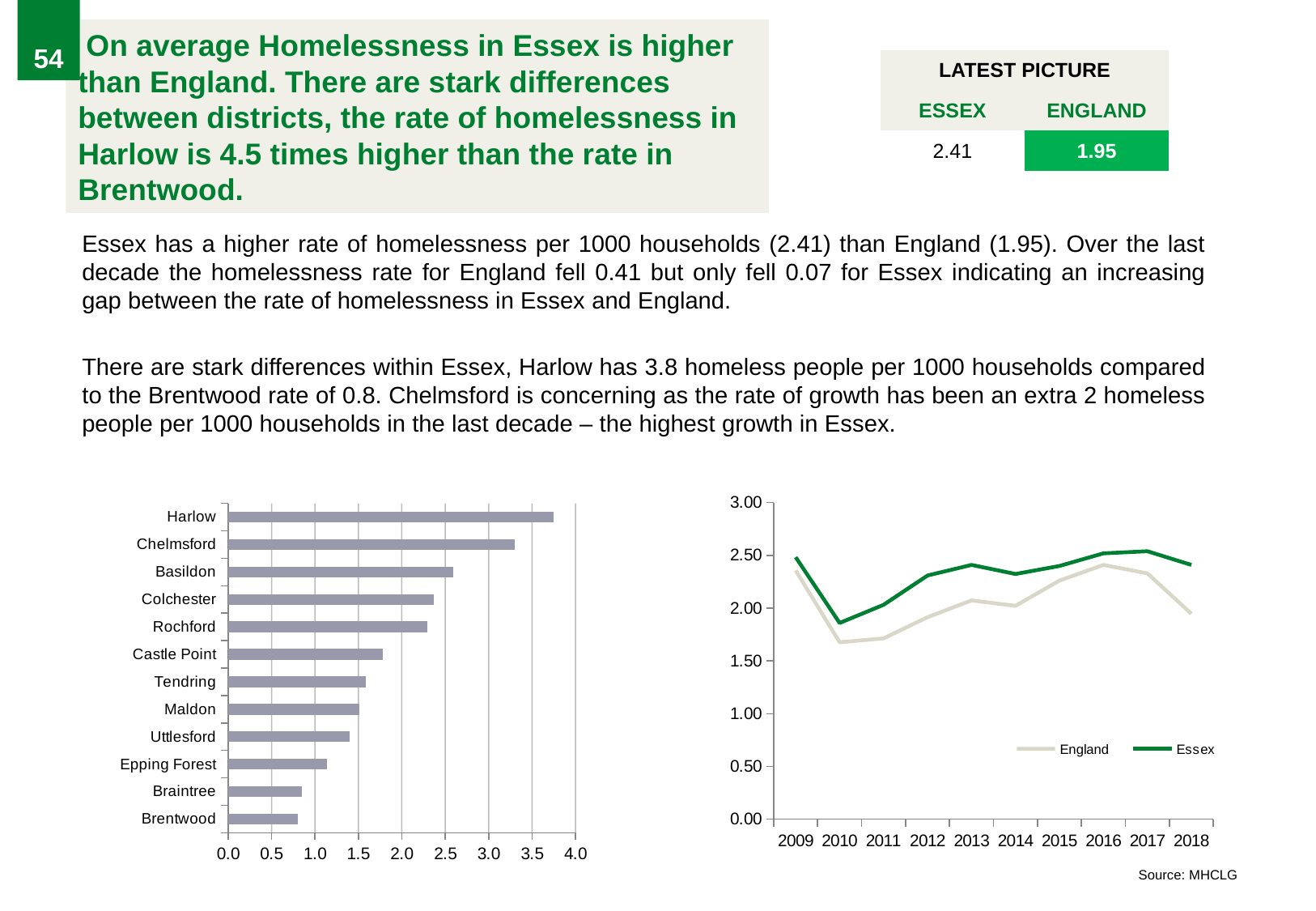
How many series does the legend of the line chart on the right list? 2 In the bar chart on the left, which district has the highest value? Harlow In the line chart on the right, which series has the higher value in 2018, England or Essex? Essex In the line chart on the right, is the value for England in 2010 greater or less than 2.00? less In the bar chart on the left, which has the larger value, Basildon or Colchester? Basildon In the bar chart on the left, is the value for Harlow greater or less than 3.5? greater How many districts are shown in the bar chart on the left? 12 In the bar chart on the left, is the value for Chelmsford greater or less than 3.0? greater In the bar chart on the left, which district has the lowest value? Brentwood What kind of chart is the chart on the left of the slide? bar chart What kind of chart is the chart on the right of the slide? line chart